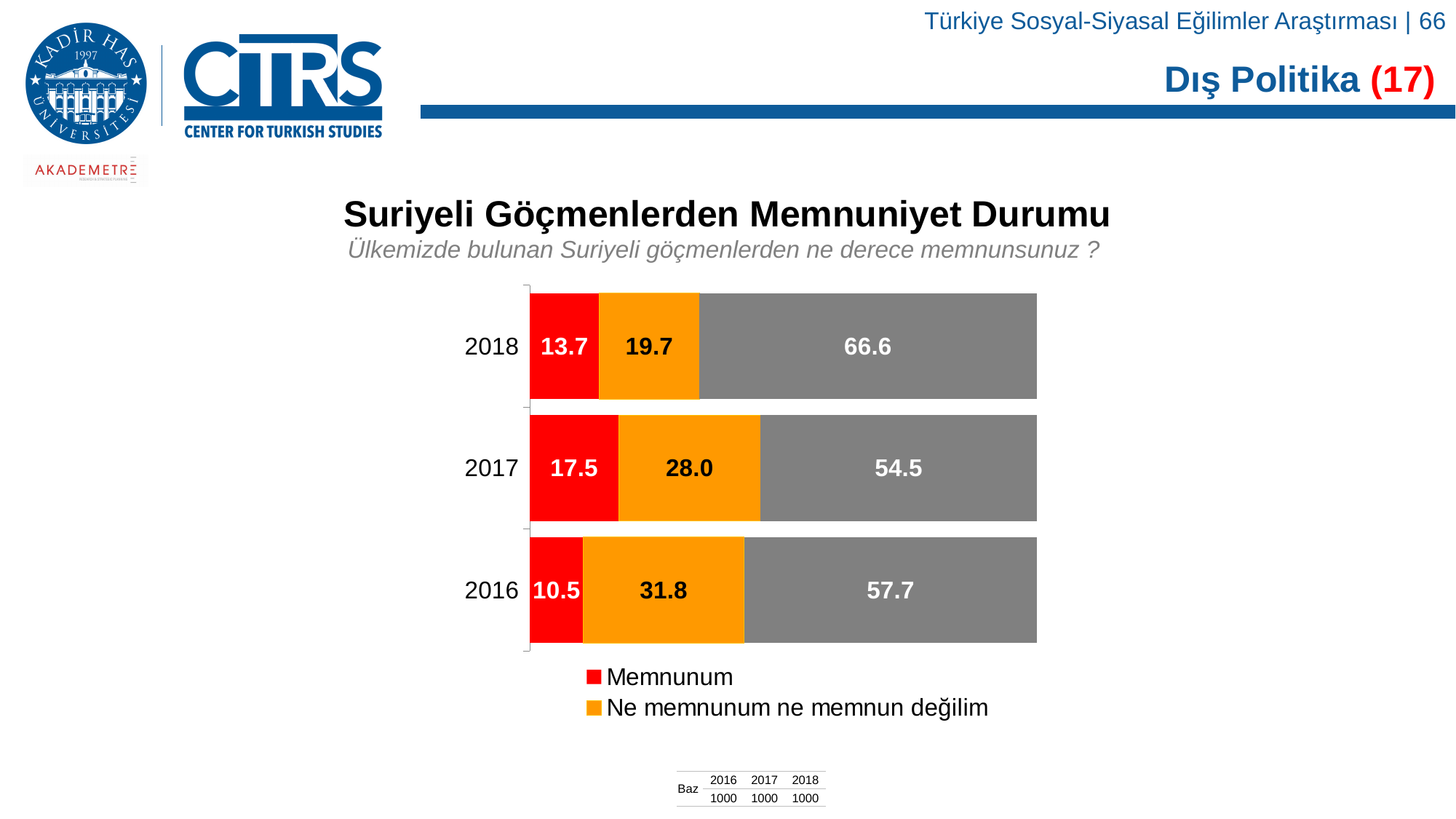
In which year is the Ne memnunum ne memnun değilim value lowest? 2018 What is the value for Memnunum in 2016? 10.5 Which year has the larger Ne memnunum ne memnun değilim value, 2016 or 2017? 2016 What is the difference between the Memnunum values for 2017 and 2016? 7.0 What is the value for Memnunum in 2018? 13.7 In which year is the Memnunum value highest? 2017 What is the value for Ne memnunum ne memnun değilim in 2017? 28.0 What is the title of the chart? Suriyeli Göçmenlerden Memnuniyet Durumu How many series does the legend list? 2 What kind of chart is shown on the slide? Stacked bar chart How many years are shown in the chart? 3 Does the Ne memnunum ne memnun değilim value rise or fall from 2016 to 2018? Fall